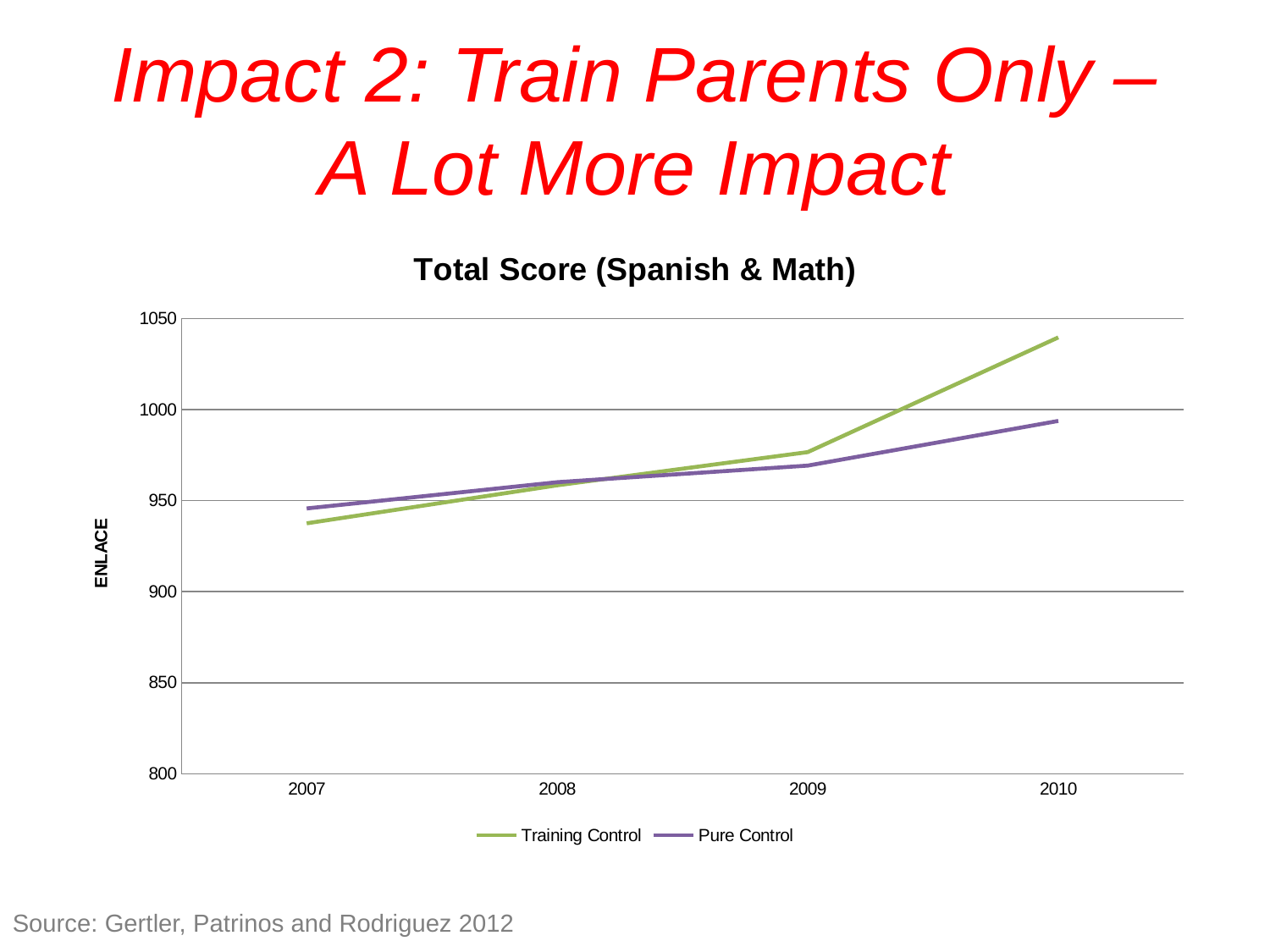
What is the label of the y axis? ENLACE How many years are plotted on the x axis? 4 What is the title of the chart? Total Score (Spanish & Math) Which series has the higher value in 2010, Training Control or Pure Control? Training Control Does the Training Control series rise or fall from 2007 to 2010? rise Is the value for Training Control in 2007 greater or less than 950? less Is the value for Pure Control in 2010 greater or less than 1000? less Is the value for Pure Control in 2009 greater or less than 950? greater What kind of chart is shown on the slide? line chart How many series does the legend list? 2 Which series has the higher value in 2007, Training Control or Pure Control? Pure Control